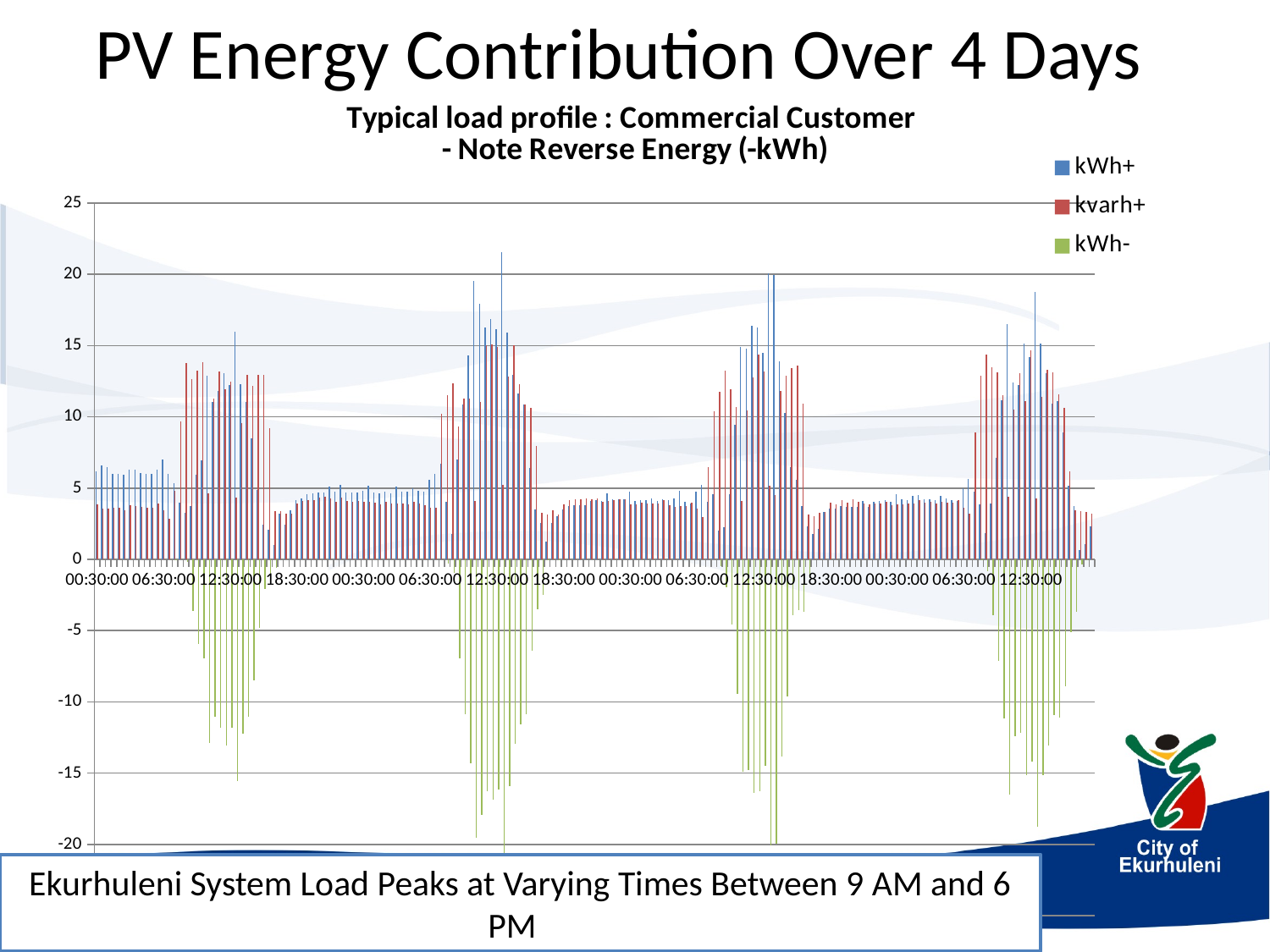
Is the tallest kWh+ bar on the chart greater or less than 20? greater How many series does the chart legend list? 3 Is the tallest kvarh+ bar on the chart greater or less than 25? less What is the lowest value shown on the chart's vertical axis? -20 Do the kWh- bars on the chart extend above or below zero? below What is the highest value shown on the chart's vertical axis? 25 What are the three series named in the chart legend? kWh+, kvarh+, kWh- What kind of chart is shown on the slide? bar chart What is the title of the chart? Typical load profile : Commercial Customer - Note Reverse Energy (-kWh) Is the most negative kWh- bar on the chart greater or less than -15? less Which series in the chart is plotted with negative values? kWh- What is the first time label shown on the chart's horizontal axis? 00:30:00